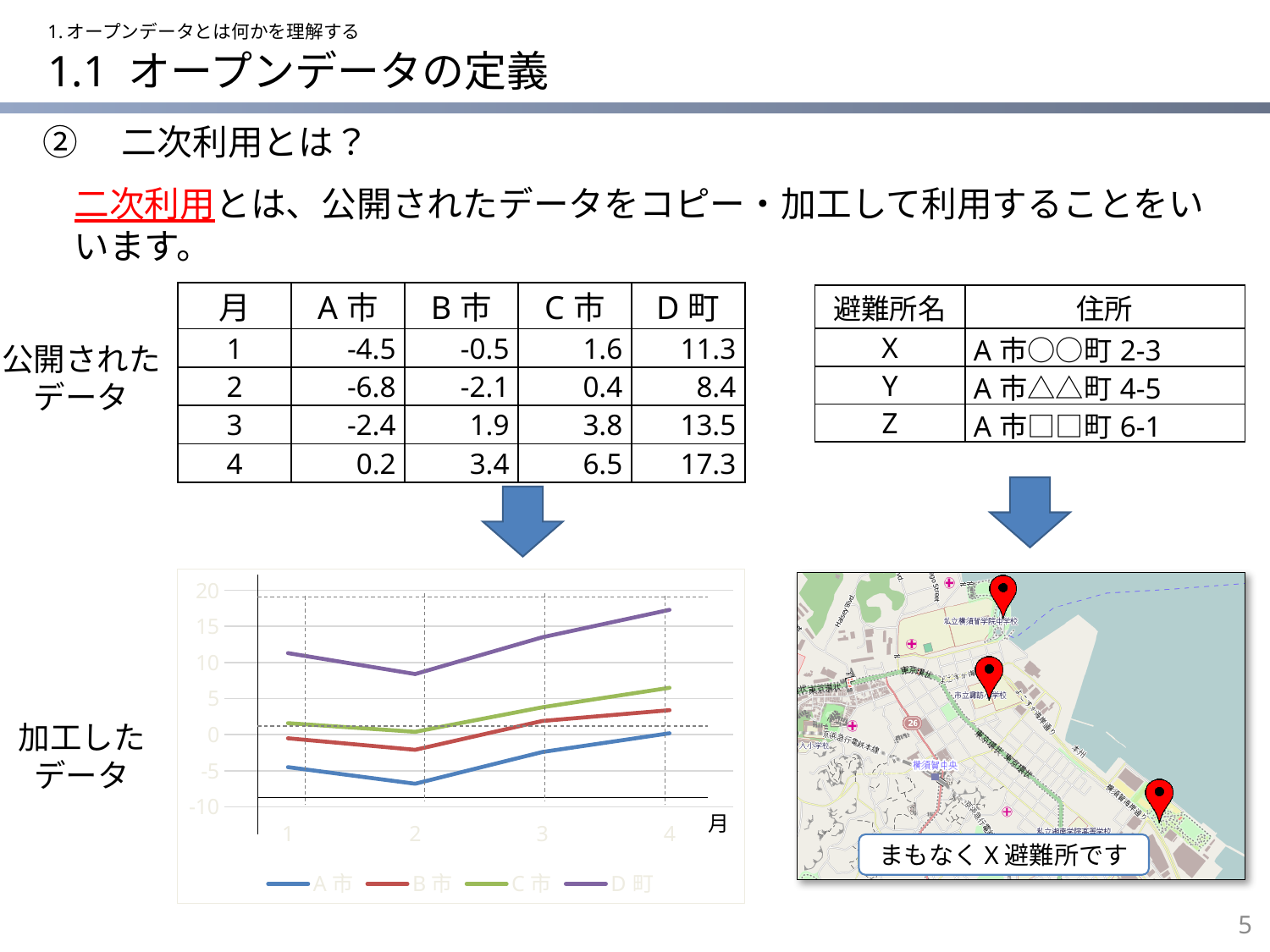
Is the value for D 町 in month 4 greater or less than 15? greater Which series has the highest value in month 4 on the line chart? D 町 Does the A 市 line rise or fall from month 2 to month 4? rise Is the value for A 市 in month 2 greater or less than -5? less What colour is the D 町 line in the line chart? purple How many series does the legend of the line chart list? 4 What kind of chart is shown at the bottom left of the slide? line chart According to the data table plotted in the line chart, what is the value for D 町 in month 1? 11.3 According to the data table plotted in the line chart, what is the value for A 市 in month 4? 0.2 Which series has the lowest value in month 2 on the line chart? A 市 How many months (points) are plotted along the x axis of the line chart? 4 Which is larger in month 3: the value for C 市 or the value for B 市? C 市